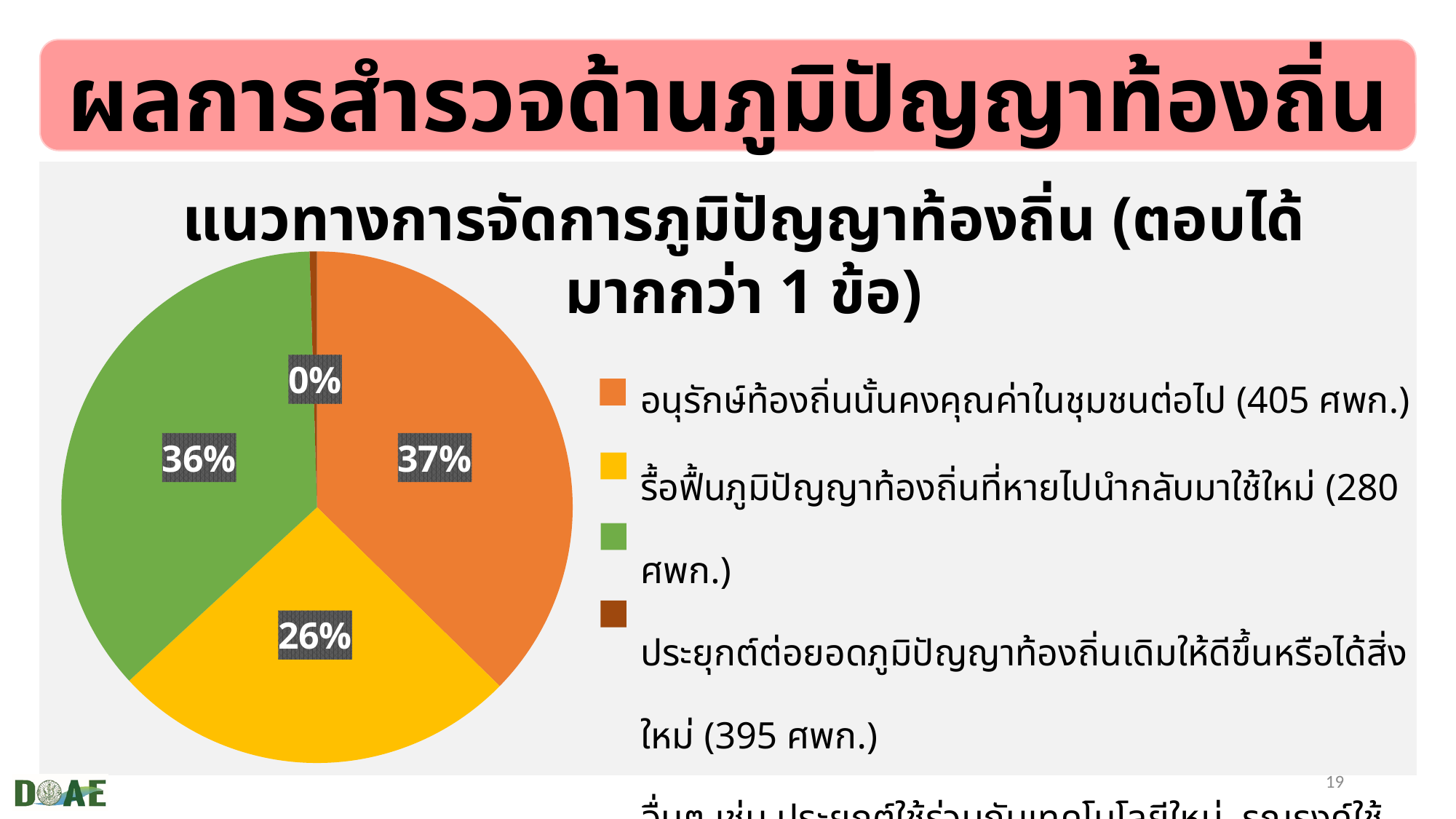
Which of the three labelled categories in the legend has the smallest share of the pie? รื้อฟื้นภูมิปัญญาท้องถิ่นที่หายไปนำกลับมาใช้ใหม่ What kind of chart is shown on the slide? Pie chart What is the title of the pie chart? แนวทางการจัดการภูมิปัญญาท้องถิ่น (ตอบได้มากกว่า 1 ข้อ) What percentage share does the slice for ประยุกต์ต่อยอดภูมิปัญญาท้องถิ่นเดิมให้ดีขึ้นหรือได้สิ่งใหม่ have? 36% What is the difference in percentage points between the orange slice (37%) and the yellow slice (26%)? 11 percentage points How many slices does the pie chart have? 4 What percentage share does the slice for อนุรักษ์ท้องถิ่นนั้นคงคุณค่าในชุมชนต่อไป have? 37% Which category has the largest share of the pie? อนุรักษ์ท้องถิ่นนั้นคงคุณค่าในชุมชนต่อไป Which slice is larger: the green slice or the yellow slice? The green slice What percentage is labelled on the brown slice of the pie chart? 0% How many entries does the legend list? 4 What percentage share does the slice for รื้อฟื้นภูมิปัญญาท้องถิ่นที่หายไปนำกลับมาใช้ใหม่ have? 26%